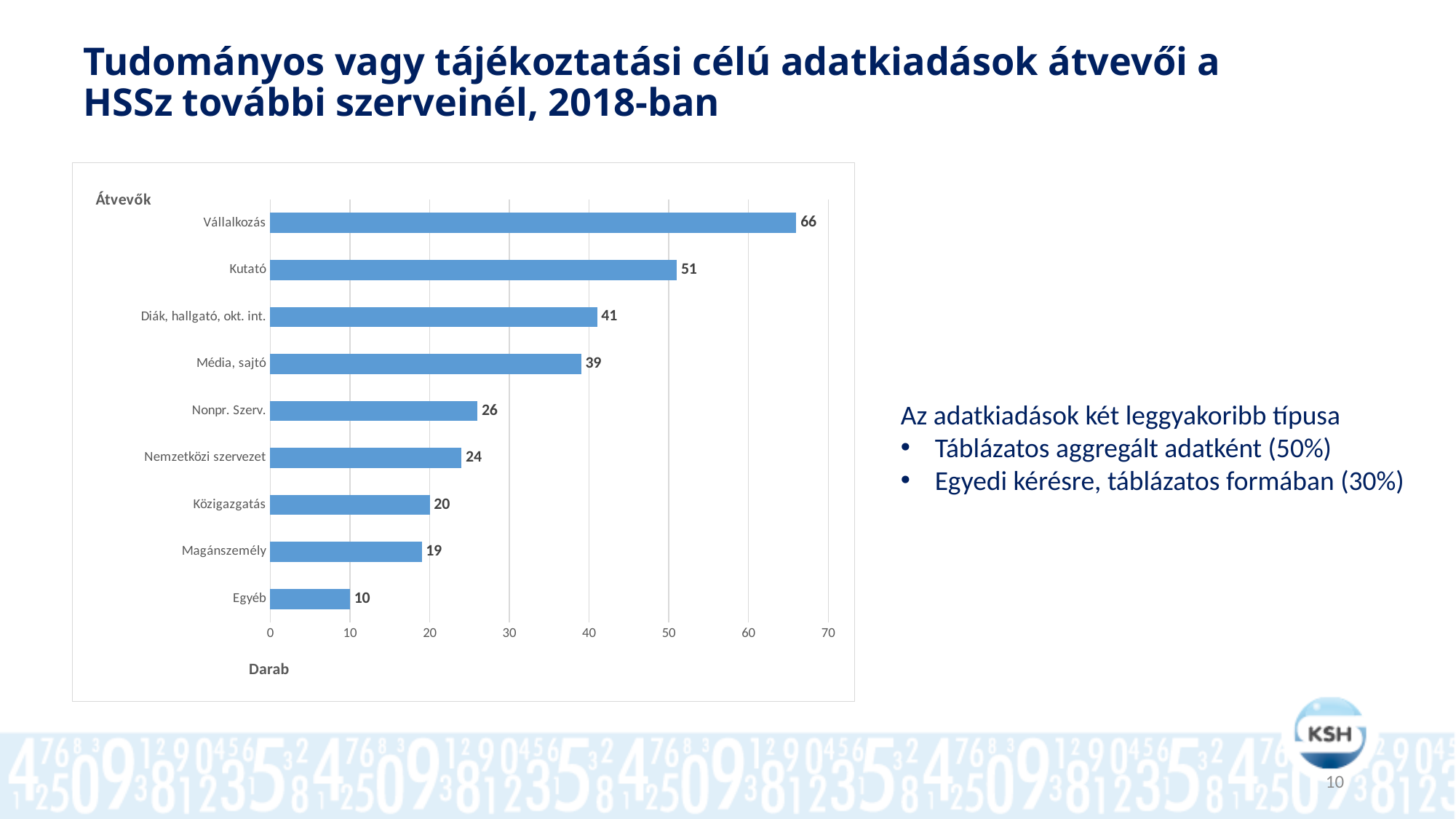
What is the value for Magánszemély? 19 What kind of chart is shown on the slide? bar chart What is the difference between the values for Vállalkozás and Kutató? 15 Which category has the lowest value? Egyéb Which category has the highest value? Vállalkozás What is the label of the horizontal axis? Darab Which is larger, the value for Diák, hallgató, okt. int. or the value for Közigazgatás? Diák, hallgató, okt. int. Is the value for Kutató greater or less than 40? greater What is the difference between the values for Nonpr. Szerv. and Nemzetközi szervezet? 2 What is the value for Média, sajtó? 39 What is the value for Vállalkozás? 66 How many categories are shown in the chart? 9